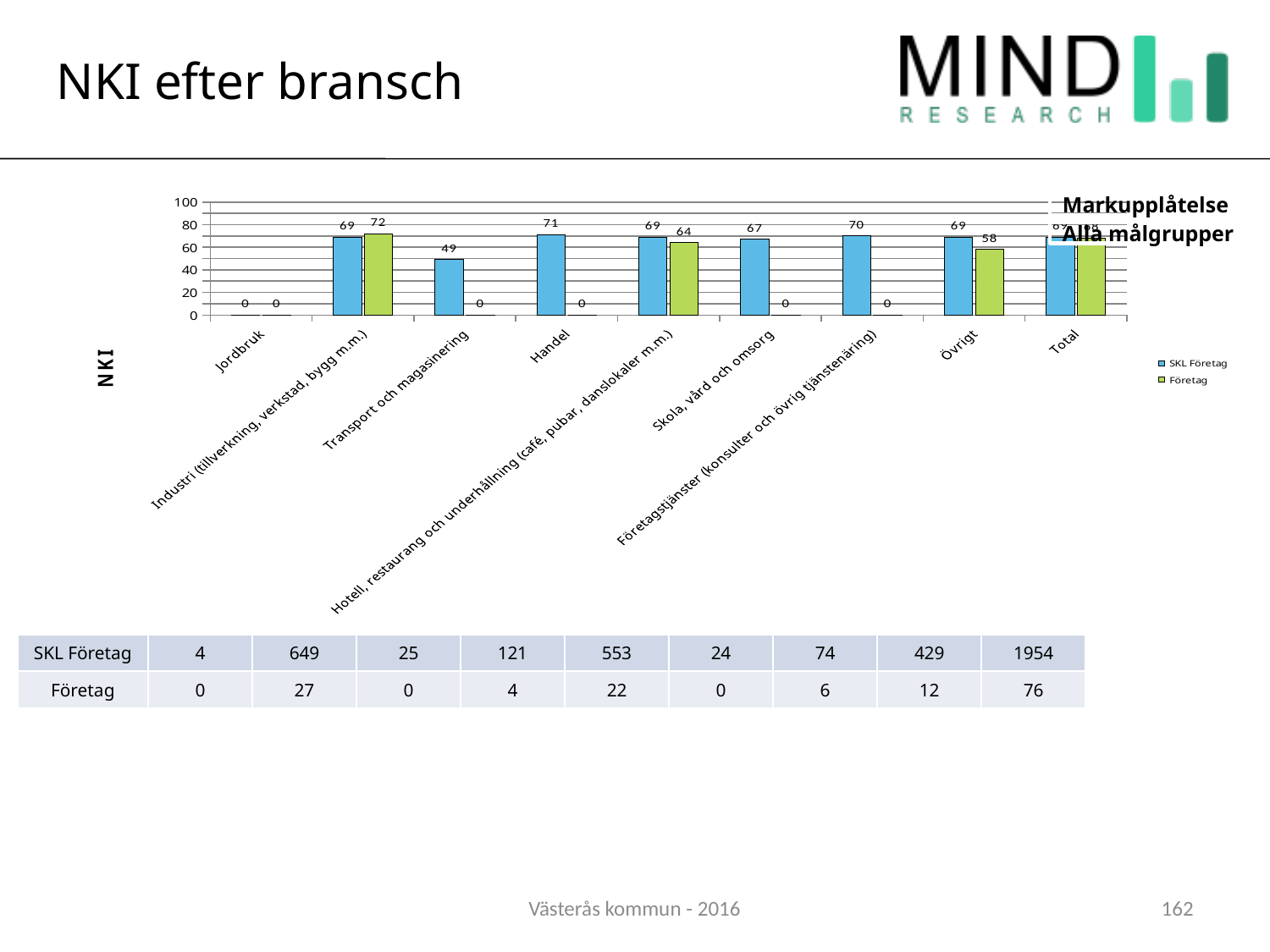
Is the SKL Företag value for Transport och magasinering greater or less than 60? less How many series does the legend list? 2 What kind of chart is shown on the slide? bar chart What is the difference between the Företag and SKL Företag values for Industri (tillverkning, verkstad, bygg m.m.)? 3 What is the SKL Företag value for Transport och magasinering? 49 Which category has the lowest SKL Företag value? Jordbruk How many categories are shown on the x axis of the chart? 9 What is the Företag value for Industri (tillverkning, verkstad, bygg m.m.)? 72 For Hotell, restaurang och underhållning, which series has the larger value, SKL Företag or Företag? SKL Företag Which category has the highest Företag value? Industri (tillverkning, verkstad, bygg m.m.) What is the SKL Företag value for Handel? 71 What is the Företag value for Övrigt? 58